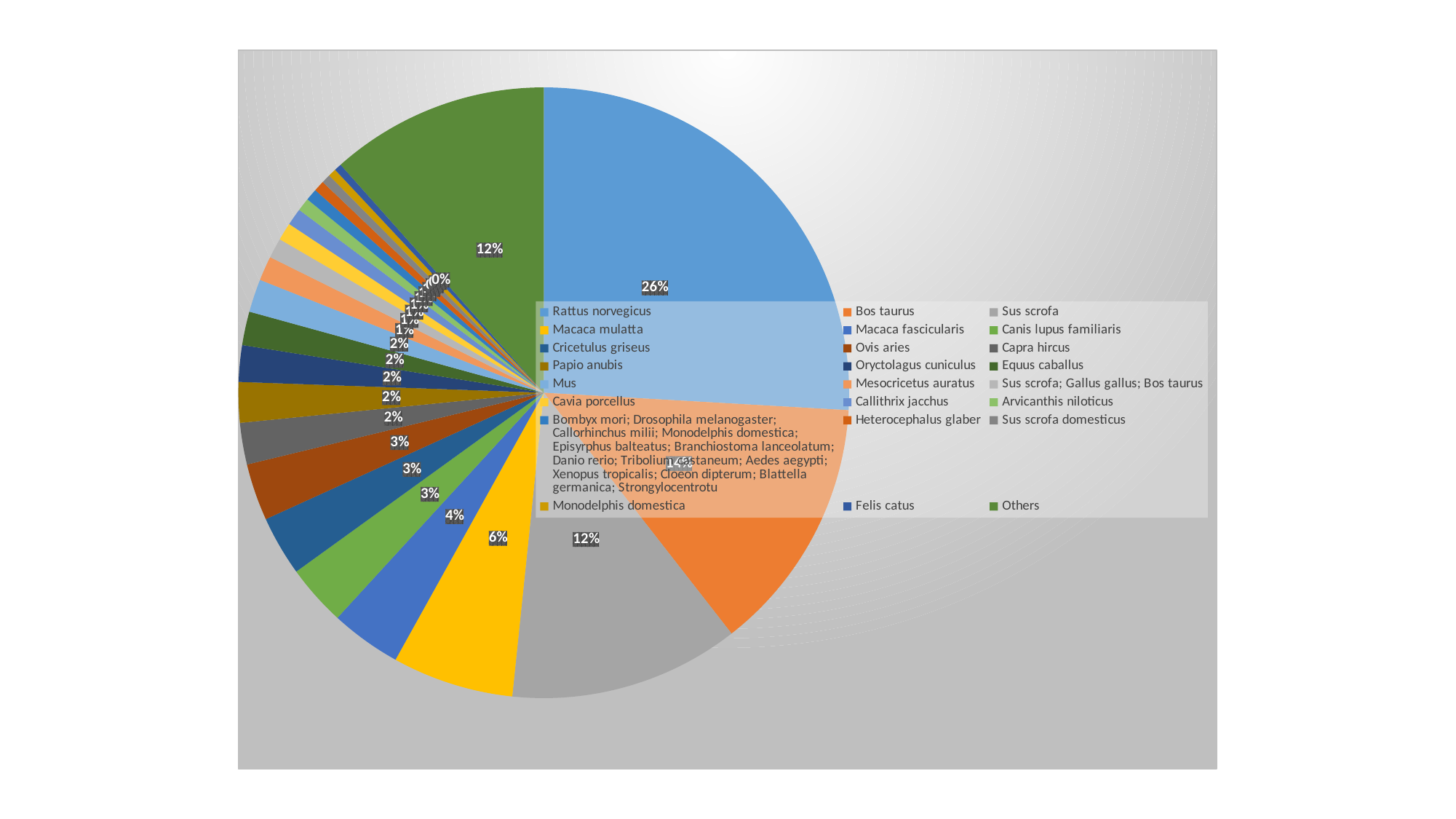
What share of the pie does Sus scrofa account for? 12% Which slice is larger, Macaca mulatta or Macaca fascicularis? Macaca mulatta What kind of chart is shown on the slide? pie chart What share of the pie does Macaca fascicularis account for? 4% What colour is the Rattus norvegicus slice? light blue Which slice is larger, Rattus norvegicus or Others? Rattus norvegicus By how many percentage points does the Rattus norvegicus share exceed the Sus scrofa share? 14 percentage points What share of the pie does Macaca mulatta account for? 6% How many entries does the legend list? 24 Which category has the largest slice of the pie? Rattus norvegicus